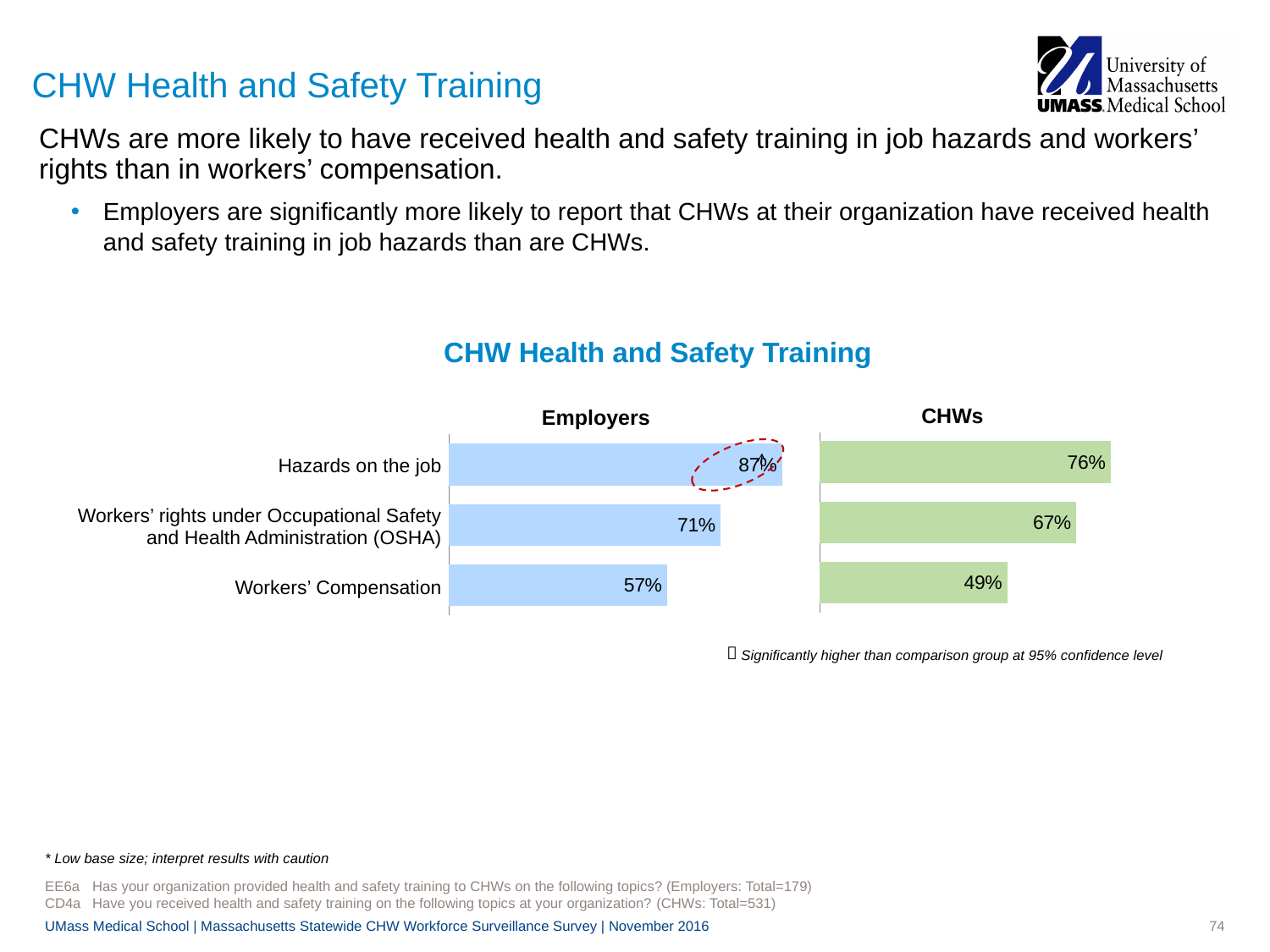
In the CHWs chart, what percentage is shown for Workers' rights under Occupational Safety and Health Administration (OSHA)? 67% What is the title of the chart on the slide? CHW Health and Safety Training In the CHWs chart, which category has the lowest value? Workers' Compensation For Workers' Compensation, which chart shows the larger value, Employers or CHWs? Employers In the Employers chart, what percentage is shown for Hazards on the job? 87% What colour are the bars in the CHWs chart? Green In the CHWs chart, what percentage is shown for Workers' Compensation? 49% In the Employers chart, what is the difference between Workers' rights under OSHA and Workers' Compensation? 14 percentage points What is the difference between the Employers value and the CHWs value for Hazards on the job? 11 percentage points How many categories are shown in the Employers chart? 3 In the Employers chart, which category has the highest value? Hazards on the job What type of chart is used to show the CHWs data? Bar chart